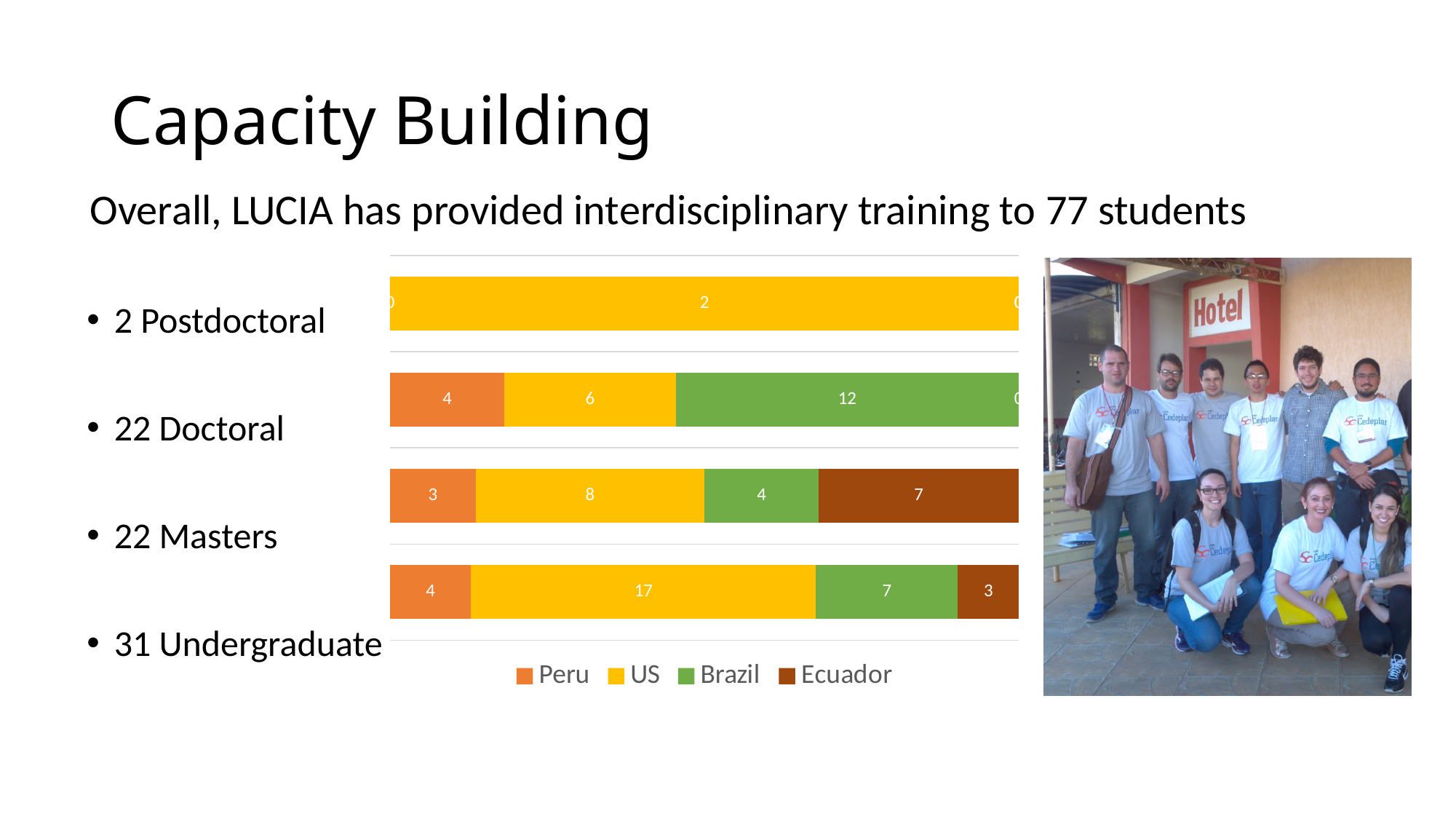
In the bottom bar, what is the difference between the US value and the Brazil value? 10 What is the total of the bottom stacked bar? 31 In the second bar from the top, what is the value for Brazil? 12 How many stacked bars are plotted in the chart? 4 What is the total of the third stacked bar from the top? 22 Which colour represents Brazil in the chart legend? green In the bottom bar, which country has the largest segment? US In the third bar from the top, which is larger: the Ecuador segment or the Brazil segment? Ecuador What kind of chart is shown on the slide? stacked bar chart In the bottom bar of the chart, what is the value for US? 17 In the third bar from the top, what is the value for Ecuador? 7 How many series does the chart legend list? 4